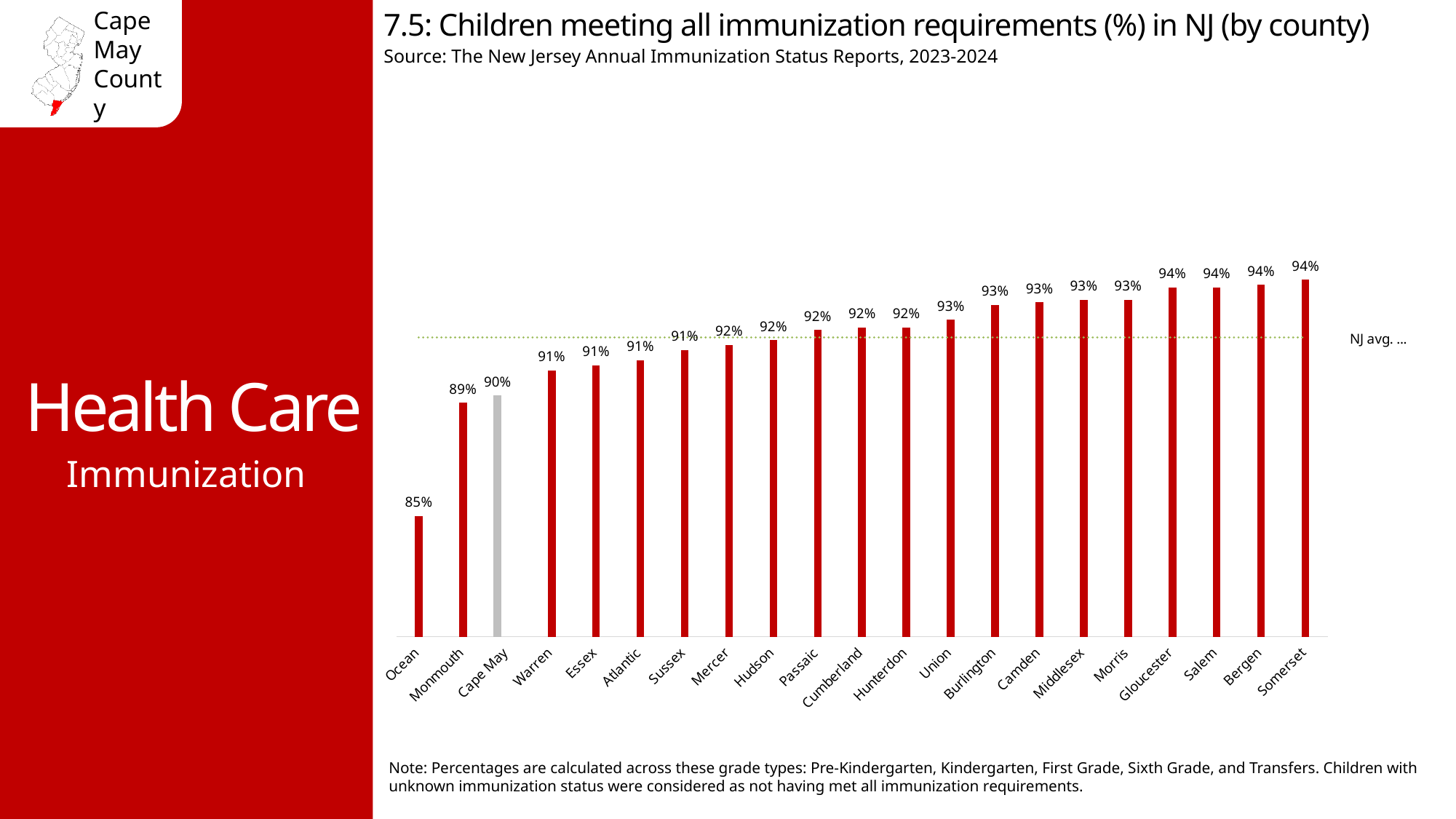
Which has a higher value, Monmouth or Warren? Warren What is the value shown for Ocean County? 85% What is the difference between the values for Somerset and Cape May? 4 percentage points What kind of chart is shown on the slide? Bar chart Which county has the lowest percentage of children meeting all immunization requirements? Ocean Do the values rise or fall moving from left to right along the x axis? Rise Which county's bar is coloured grey instead of red? Cape May What is the value shown for Hudson County? 92% What is the value shown for Somerset County? 94% What is the difference between the values for Cape May and Ocean? 5 percentage points What percentage of children in Cape May County met all immunization requirements? 90% How many counties are shown on the chart? 21